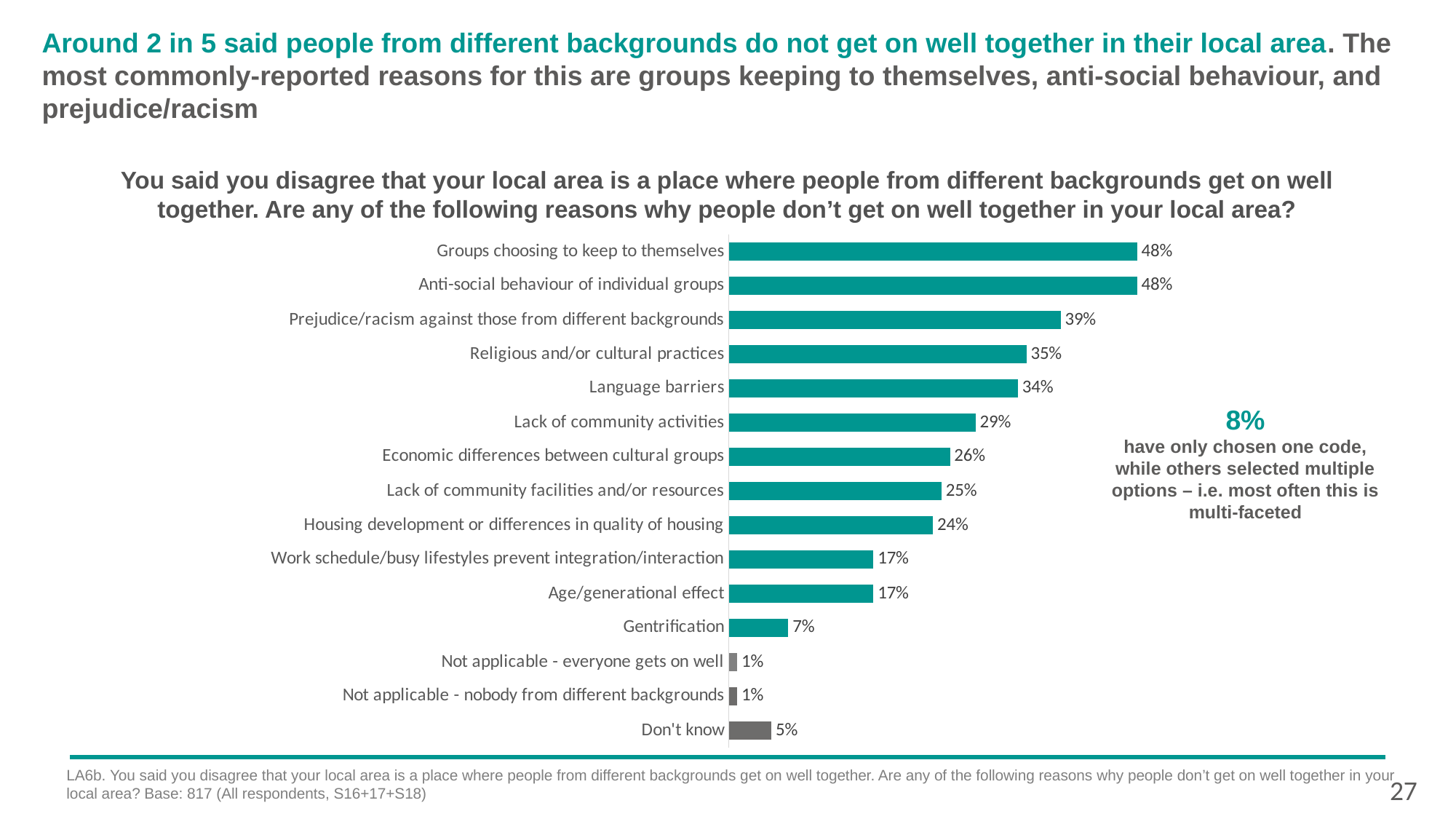
What is the value for Language barriers? 34% What colour is the bar for Don't know? grey What is the value for Gentrification? 7% What kind of chart is shown on the slide? bar chart What is the difference between the value for Groups choosing to keep to themselves and the value for Prejudice/racism against those from different backgrounds? 9 percentage points What is the lowest value shown in the chart? 1% What is the value for Prejudice/racism against those from different backgrounds? 39% What is the value for Housing development or differences in quality of housing? 24% Which is larger: the value for Language barriers or the value for Lack of community activities? Language barriers What is the highest value shown in the chart? 48% What is the value for Don't know? 5% How many categories are shown in the chart? 15